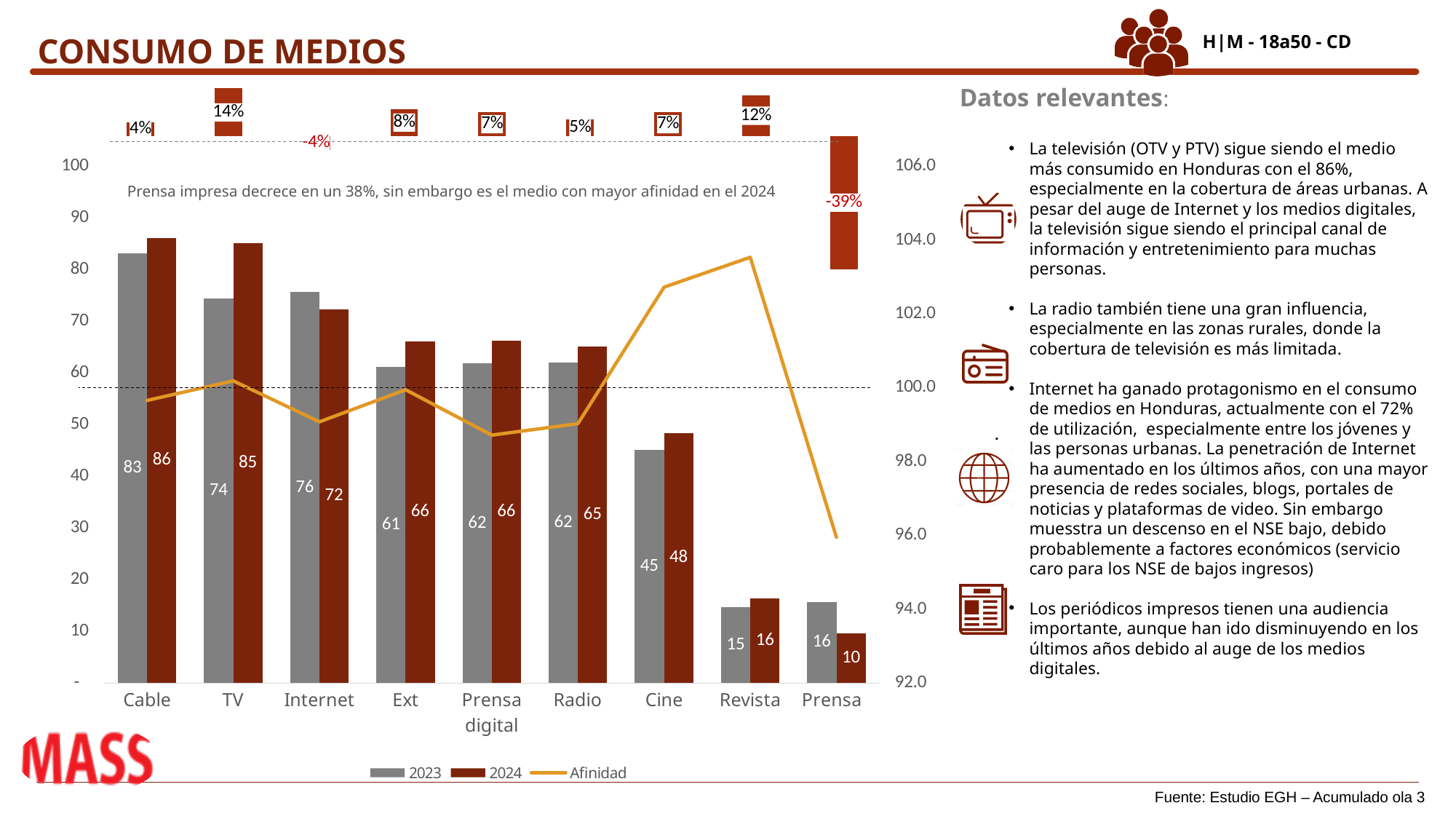
Which category has the highest 2024 value? Cable What percentage change is shown above the chart for Prensa? -39% What is the 2024 value for TV? 85 Is the Afinidad value for Prensa greater or less than 98.0? less Is the Afinidad value for Revista greater or less than 102.0? greater How many series does the chart legend list? 3 Which category has the lowest 2023 value? Revista How many categories are shown on the x axis of the chart? 9 For Internet, which is larger: the 2023 value or the 2024 value? 2023 Which category has the lowest 2024 value? Prensa What is the difference between the 2024 and 2023 values for TV? 11 What is the 2023 value for Internet? 76